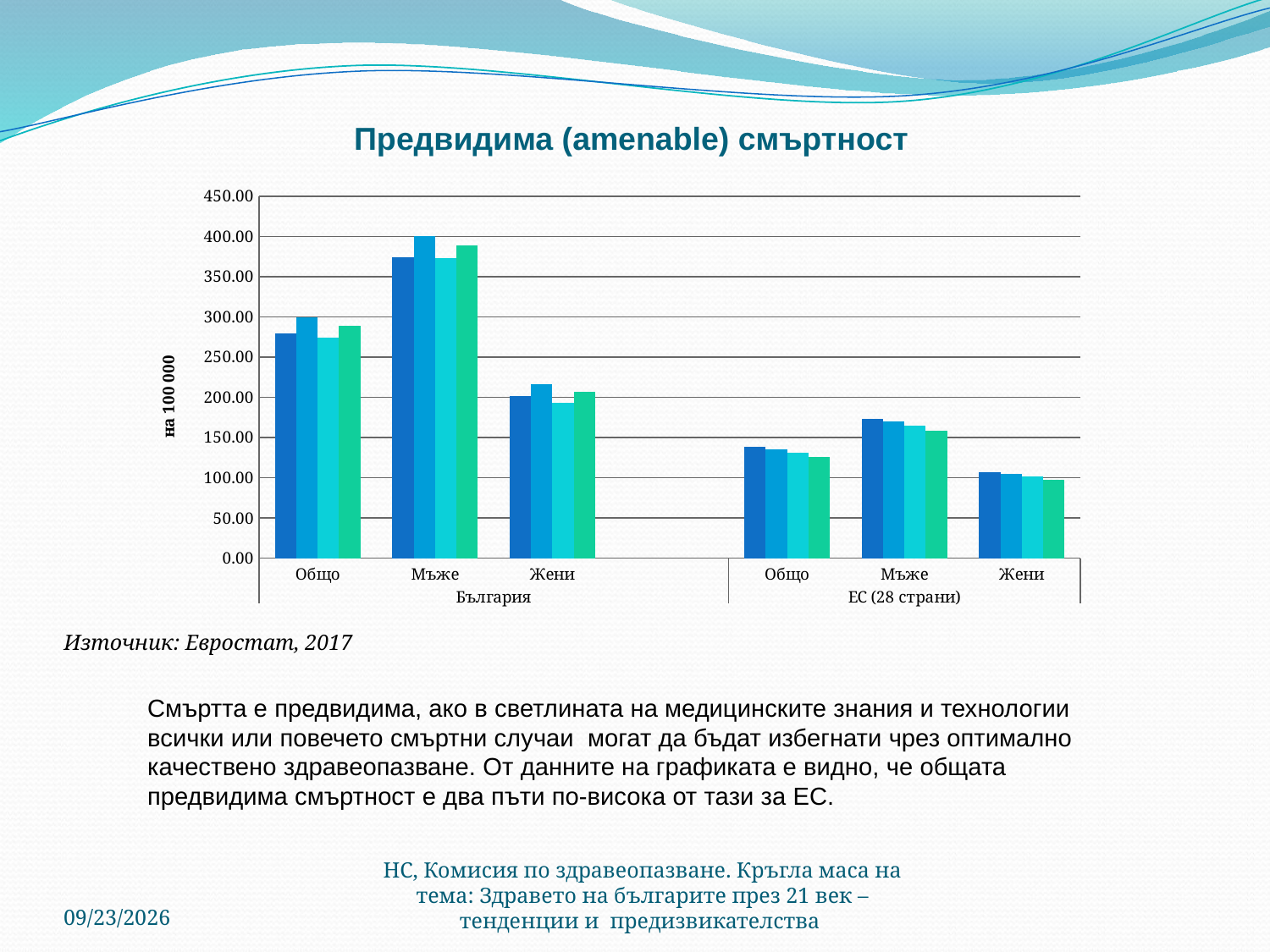
Are the values for Общо in България greater or less than 250? greater Are the values for Общо in ЕС (28 страни) greater or less than 150? less How many category groups are shown along the x axis of the chart? 6 What is the label on the vertical axis of the chart? на 100 000 Are the values for Мъже in България greater or less than 350? greater How many bars are plotted in each category group? 4 Which category group has the highest bars in the chart? Мъже (България) What kind of chart is shown on the slide? bar chart Which category group has the lowest bars in the chart? Жени (ЕС (28 страни)) Within the Общо group for ЕС (28 страни), do the four bars rise or fall from left to right? fall What is the title of the chart? Предвидима (amenable) смъртност Which is larger: the values for Общо in България or the values for Общо in ЕС (28 страни)? Общо in България